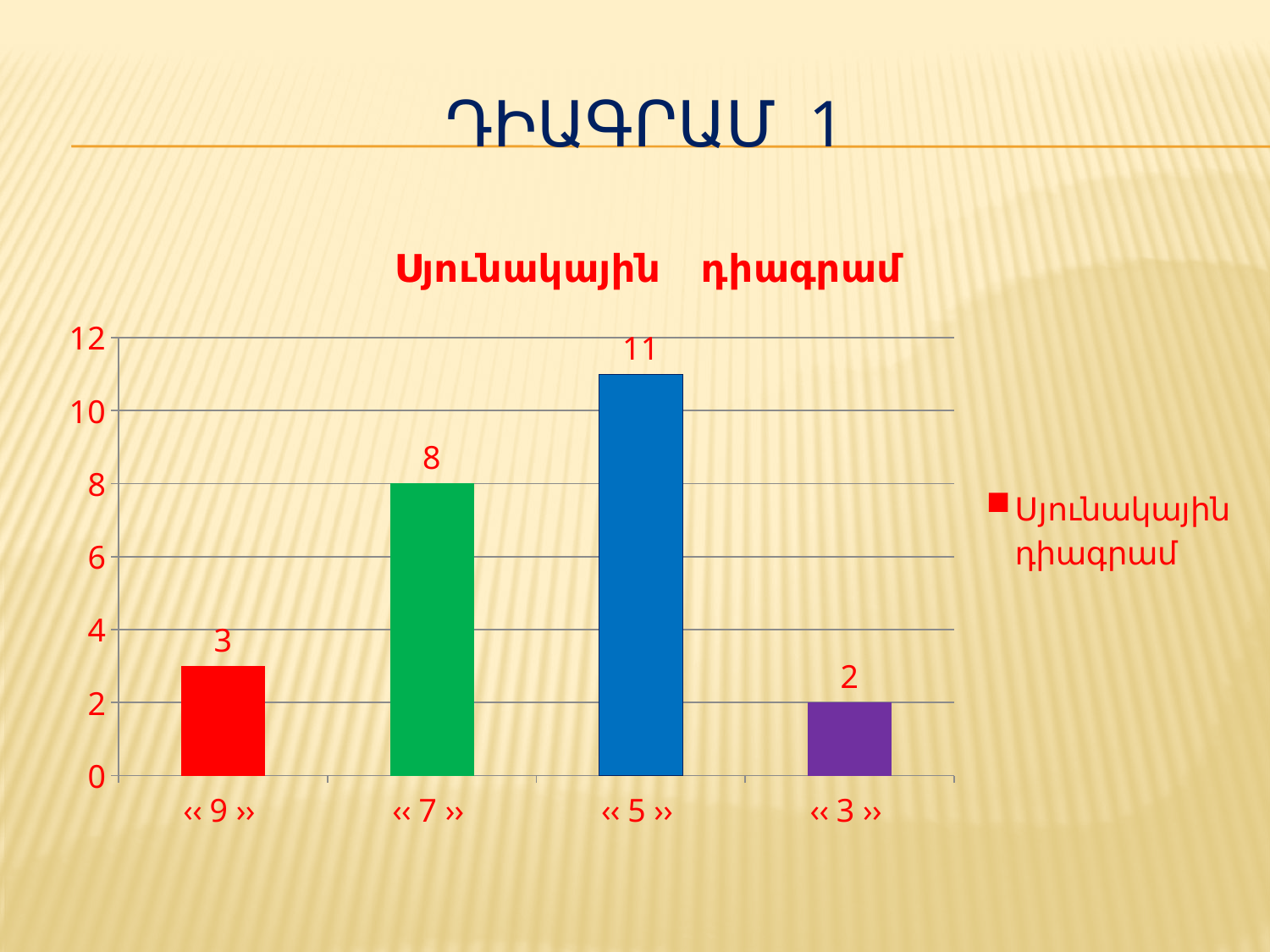
Which category has the lowest value? «3» Which category has the highest value? «5» Which is larger, the value for «9» or the value for «7»? «7» What is the value for the category «3»? 2 Is the value for «5» greater or less than 10? greater What is the difference between the values for «5» and «7»? 3 What is the value for the category «5»? 11 What kind of chart is shown on the slide? bar chart What is the value for the category «7»? 8 What is the title of the chart? Սյունակային դիագրամ What is the value for the category «9»? 3 How many categories are shown on the x axis? 4